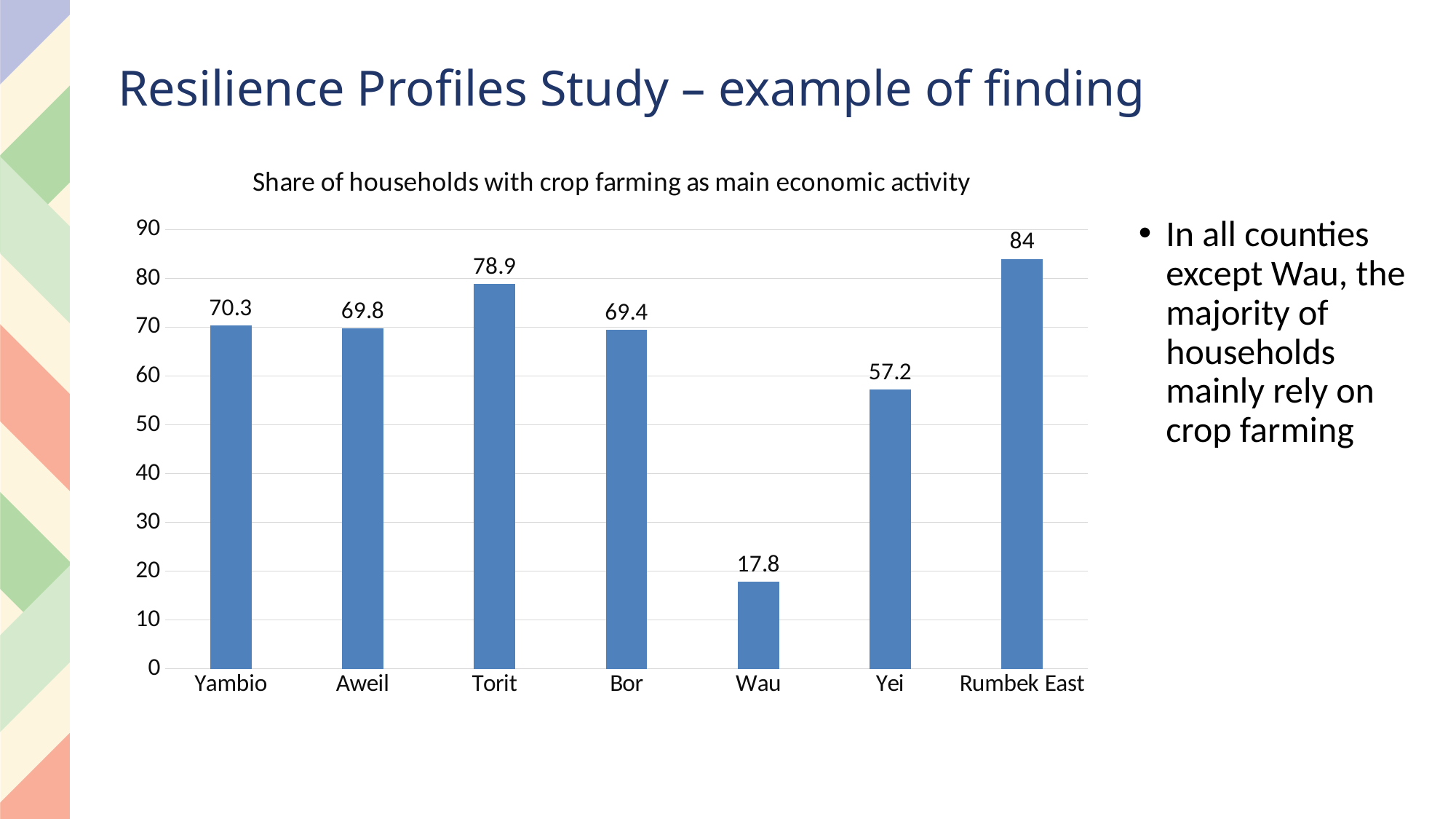
How many counties are shown on the chart? 7 What is the difference between the values for Rumbek East and Wau? 66.2 What kind of chart is shown on the slide? Bar chart Which county has the highest share of households with crop farming as main economic activity? Rumbek East What is the value for Wau? 17.8 Which is larger, the value for Yambio or the value for Yei? Yambio Which county has the lowest share of households with crop farming as main economic activity? Wau What is the difference between the values for Torit and Yei? 21.7 What is the value for Torit? 78.9 What is the title of the chart? Share of households with crop farming as main economic activity Is the value for Bor greater or less than 60? greater What is the value for Yei? 57.2